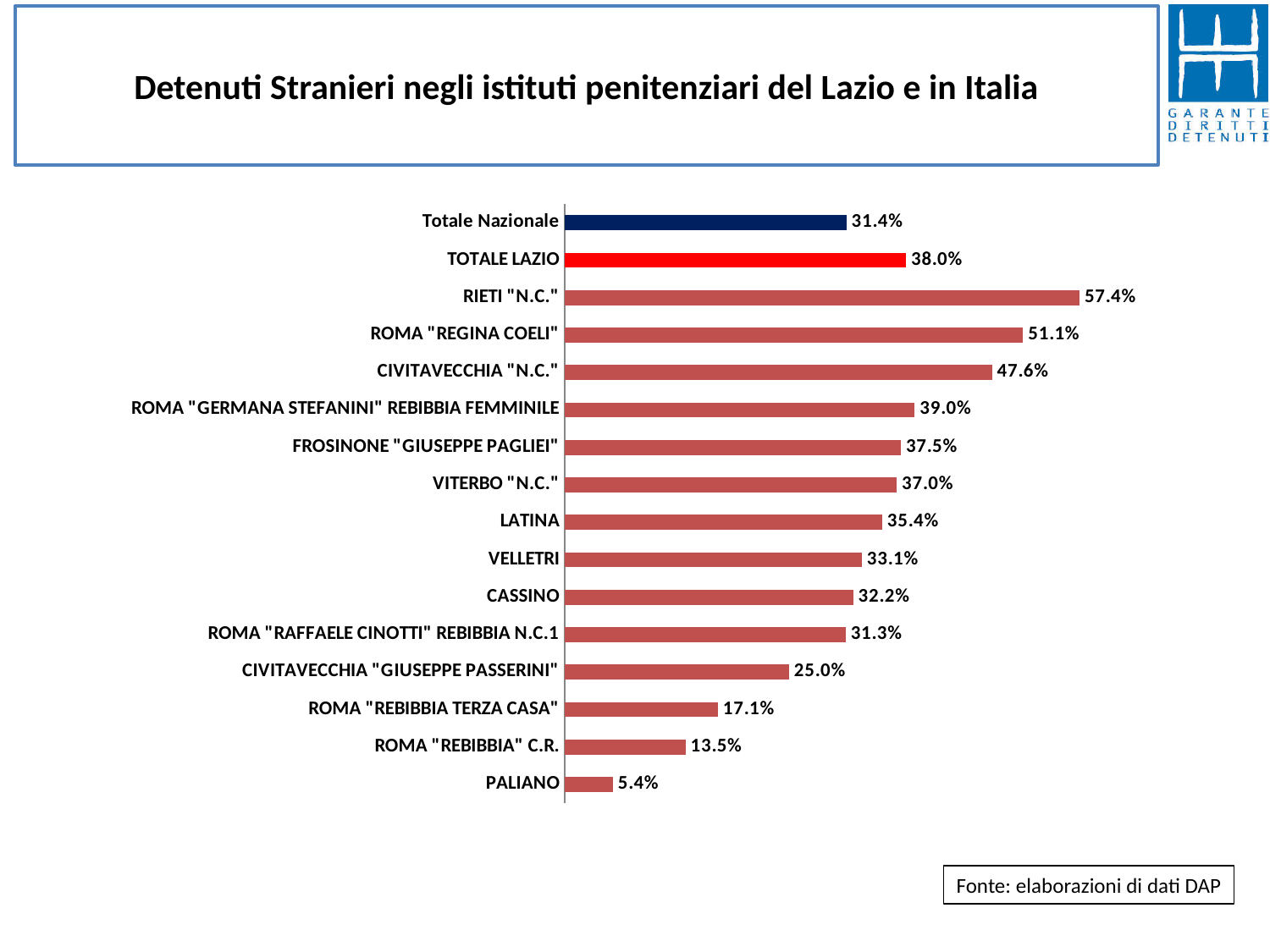
What is the difference between the values for RIETI "N.C." and ROMA "REGINA COELI"? 6.3% What is the value for ROMA "REBIBBIA" C.R.? 13.5% Which category has the lowest value? PALIANO What kind of chart is shown on the slide? Bar chart What is the difference between the values for TOTALE LAZIO and Totale Nazionale? 6.6% What is the value for TOTALE LAZIO? 38.0% What is the value for CIVITAVECCHIA "N.C."? 47.6% What is the value for Totale Nazionale? 31.4% How many categories are shown in the chart? 16 Which category has the highest value? RIETI "N.C." Which is larger, the value for LATINA or the value for VELLETRI? LATINA What is the title of the slide? Detenuti Stranieri negli istituti penitenziari del Lazio e in Italia